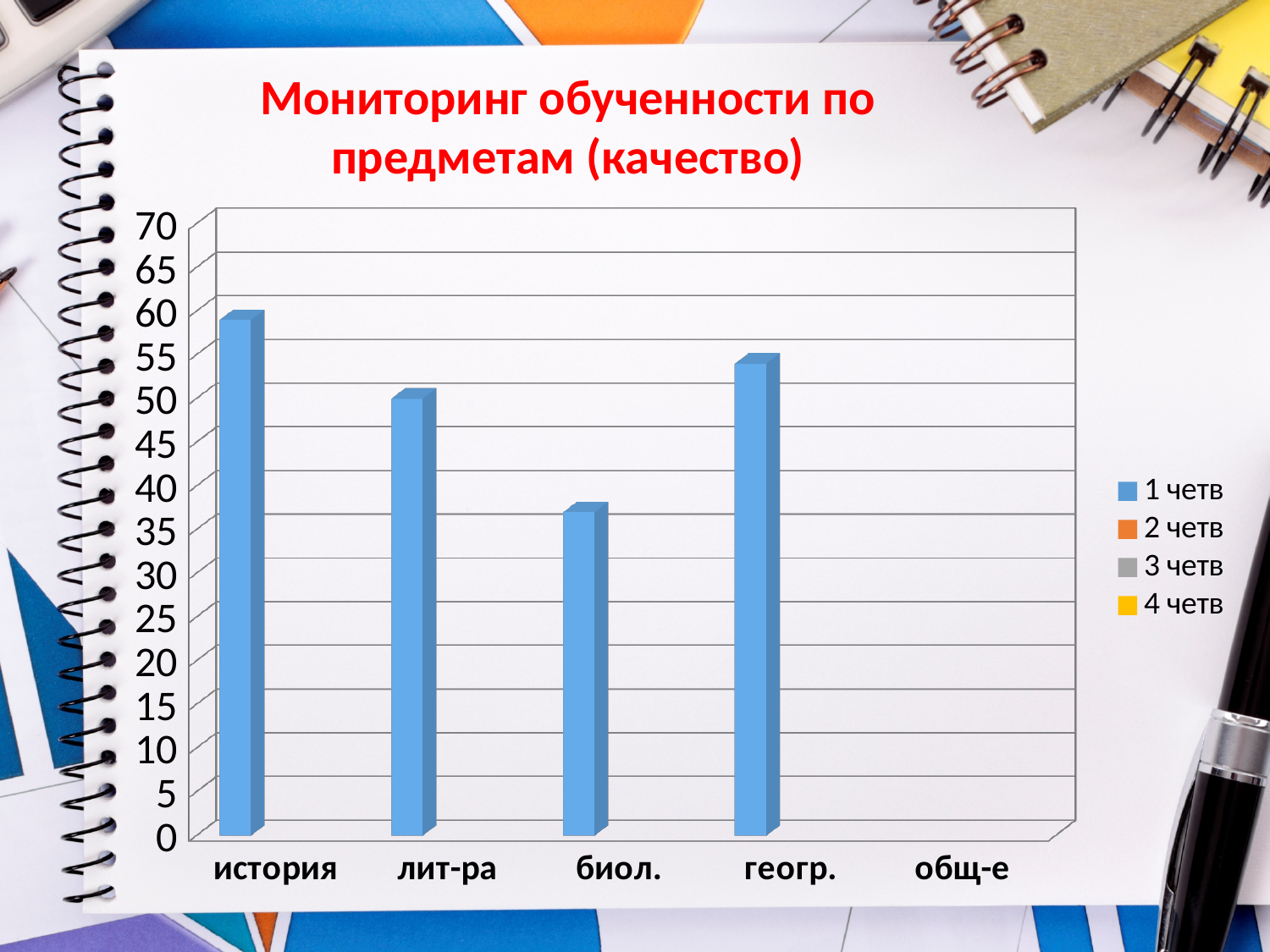
Is the value for биол. greater or less than 40? less Which category has the highest bar in the chart? история Is the value for геогр. greater or less than 50? greater Is the value for лит-ра greater or less than 45? greater What kind of chart is shown on the slide? bar chart Which is larger, the value for лит-ра or the value for биол.? лит-ра Which is larger, the value for история or the value for геогр.? история What is the title of the chart? Мониторинг обученности по предметам (качество) How many series does the legend list? 4 Among the categories with a visible bar, which has the lowest value? биол. How many categories are shown on the x axis of the chart? 5